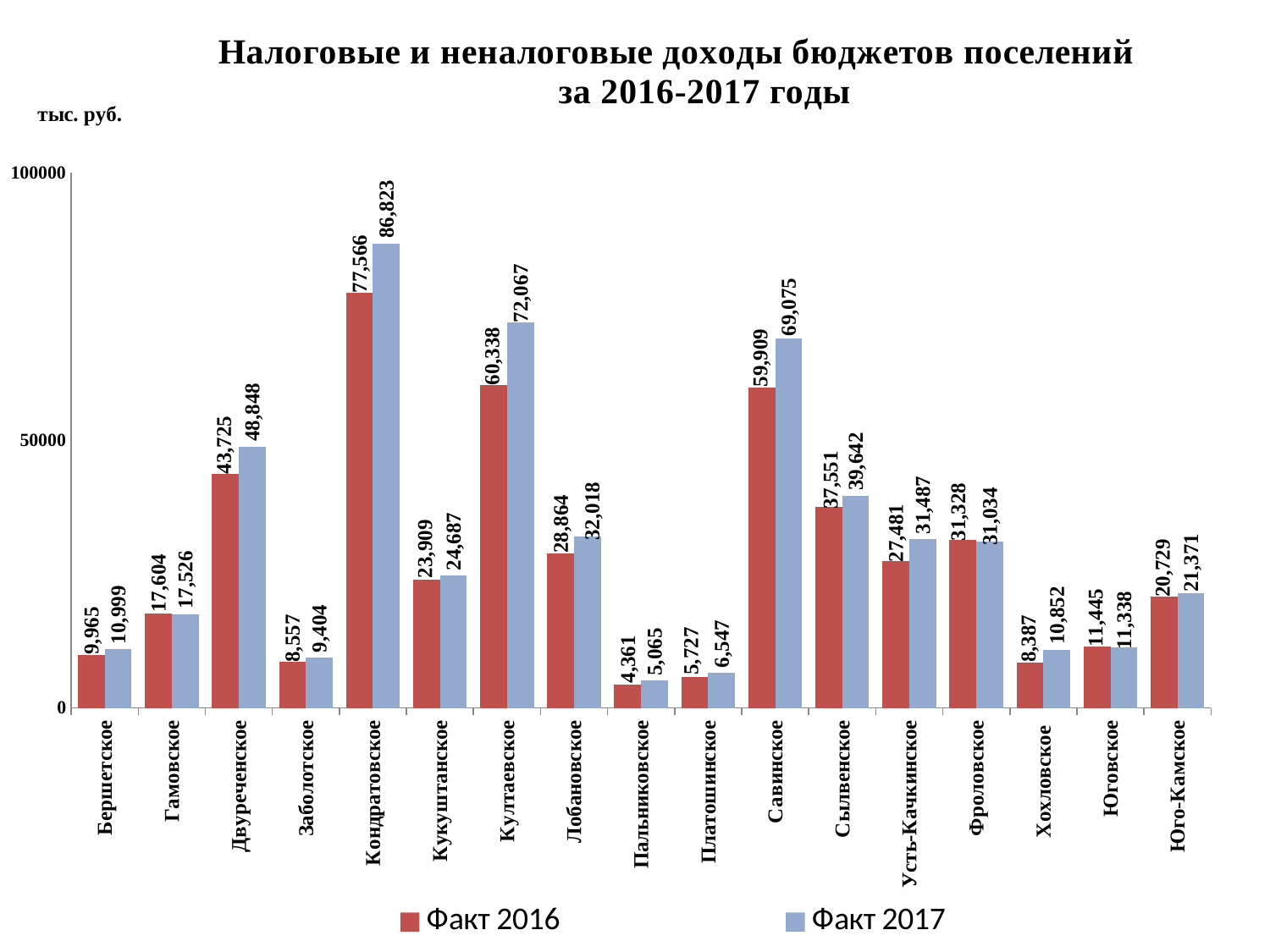
Which settlement has the lowest Факт 2016 value? Пальниковское How many series does the legend list? 2 What is the Факт 2017 value for Хохловское? 10,852 Is the Факт 2017 value for Култаевское greater or less than 50000? greater What is the Факт 2016 value for Савинское? 59,909 How many settlements are shown on the x axis? 17 What unit is indicated for the values on the chart? тыс. руб. What kind of chart is shown on the slide? bar chart Which settlement has the highest Факт 2017 value? Кондратовское Which is larger: the Факт 2016 value for Савинское or the Факт 2016 value for Сылвенское? Савинское What is the difference between the Факт 2017 and Факт 2016 values for Култаевское? 11,729 What is the Факт 2017 value for Кондратовское? 86,823